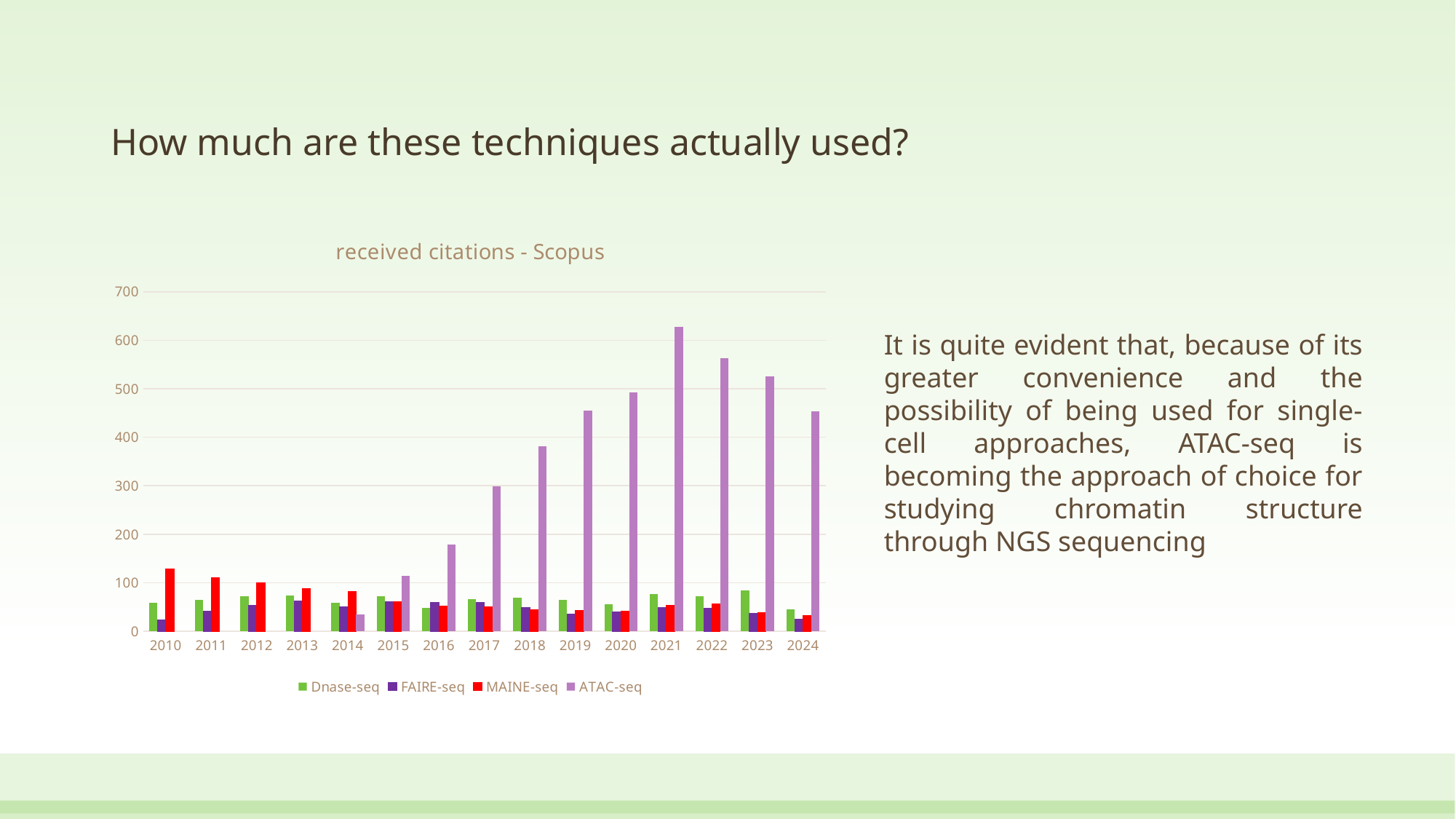
Which is larger, the ATAC-seq value in 2021 or in 2022? 2021 Is the value for MAINE-seq in 2010 greater or less than 100? greater How many series does the chart legend list? 4 What kind of chart is shown on the slide? bar chart How many years are shown on the x axis of the chart? 15 In which year does ATAC-seq reach its highest value? 2021 Is the value for ATAC-seq in 2016 greater or less than 200? less What is the title of the chart? received citations - Scopus Do the ATAC-seq values rise or fall from 2014 to 2021? rise Which series are listed in the chart legend? Dnase-seq, FAIRE-seq, MAINE-seq, ATAC-seq Which series has the tallest bar anywhere in the chart? ATAC-seq Is the value for ATAC-seq in 2021 greater or less than 600? greater